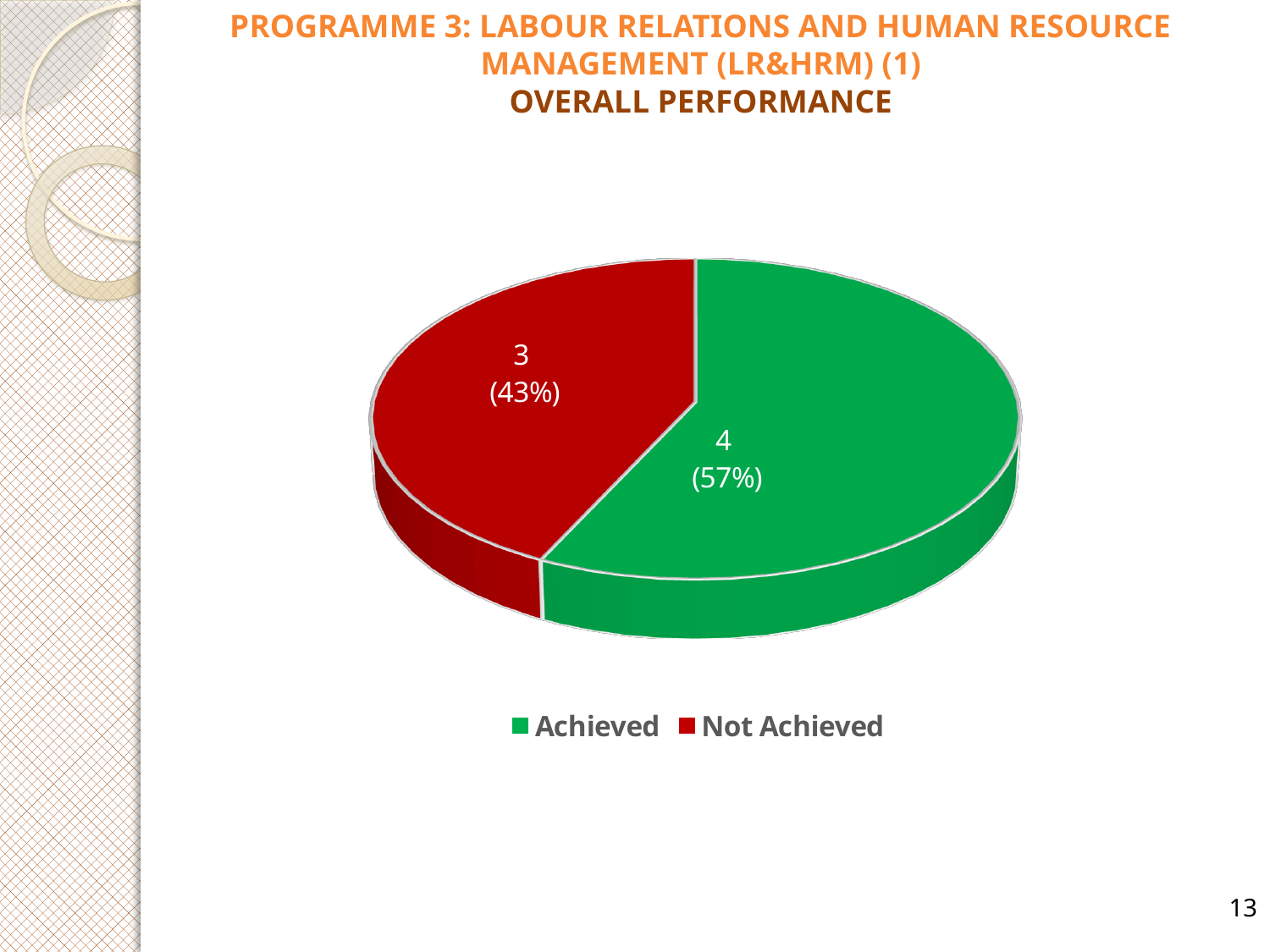
Which category has the larger slice, Achieved or Not Achieved? Achieved What percentage of the pie does the Achieved slice represent? 57% What percentage of the pie does the Not Achieved slice represent? 43% Which category has the smallest slice in the pie chart? Not Achieved What colour is the Not Achieved slice? Red How many targets were Achieved? 4 How many slices does the pie chart have? 2 What is the difference between the number of Achieved and Not Achieved targets? 1 How many targets were Not Achieved? 3 How many entries does the legend list? 2 What is the total number of targets shown in the pie chart? 7 What kind of chart is shown on the slide? Pie chart